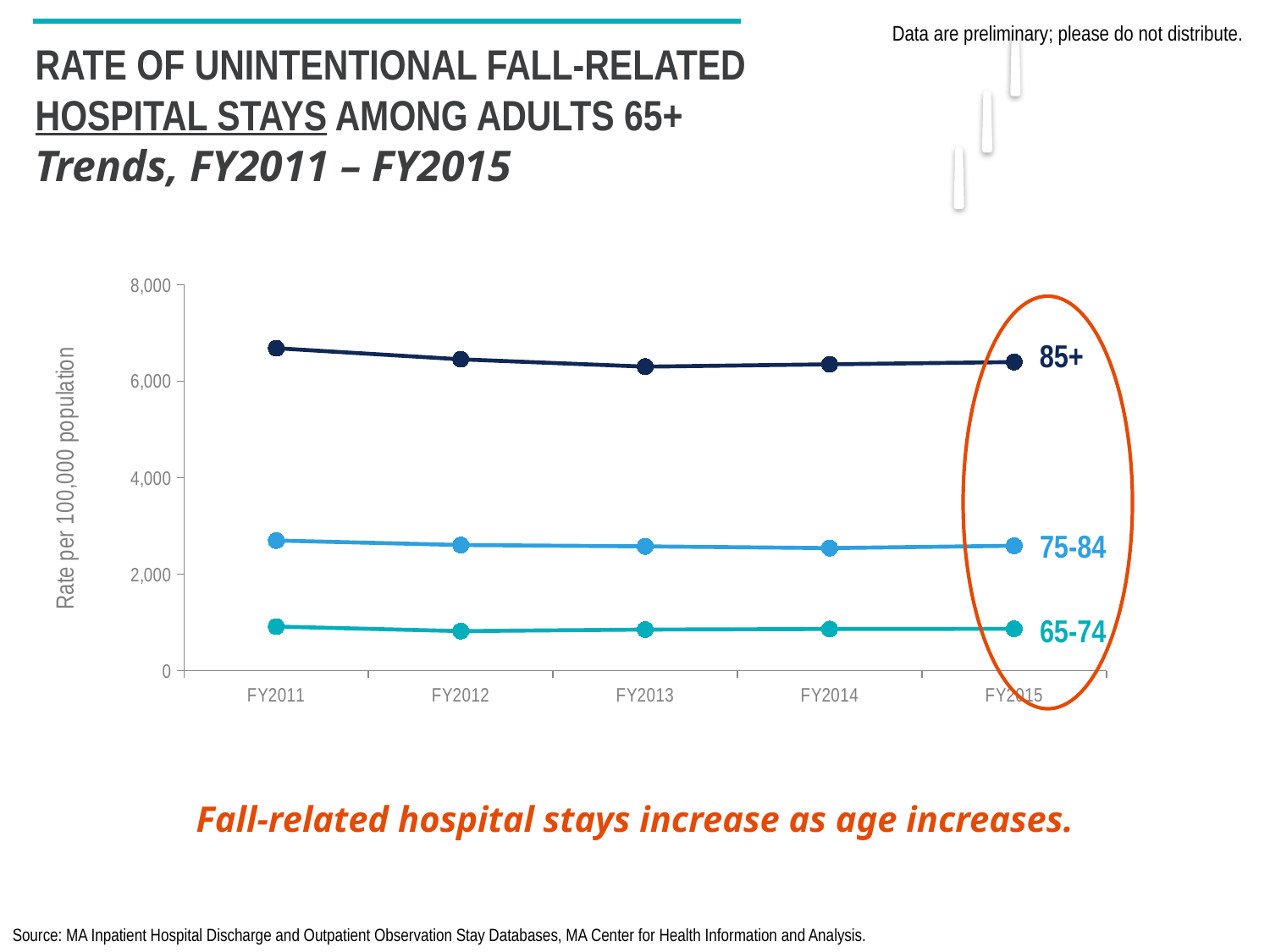
What kind of chart is shown on the slide? line chart Does the rate for the 85+ group rise or fall from FY2011 to FY2013? fall Is the value for the 65-74 group in FY2013 greater or less than 2,000? less In FY2014, which group has the larger rate: 85+ or 75-84? 85+ How many fiscal years are shown along the x axis? 5 Is the value for the 85+ group in FY2011 greater or less than 6,000? greater How many age groups are plotted as separate lines on the chart? 3 What is the label on the y axis of the chart? Rate per 100,000 population Is the value for the 75-84 group in FY2015 greater or less than 4,000? less Which age group has the highest rate of fall-related hospital stays across all years? 85+ Which age group has the lowest rate of fall-related hospital stays across all years? 65-74